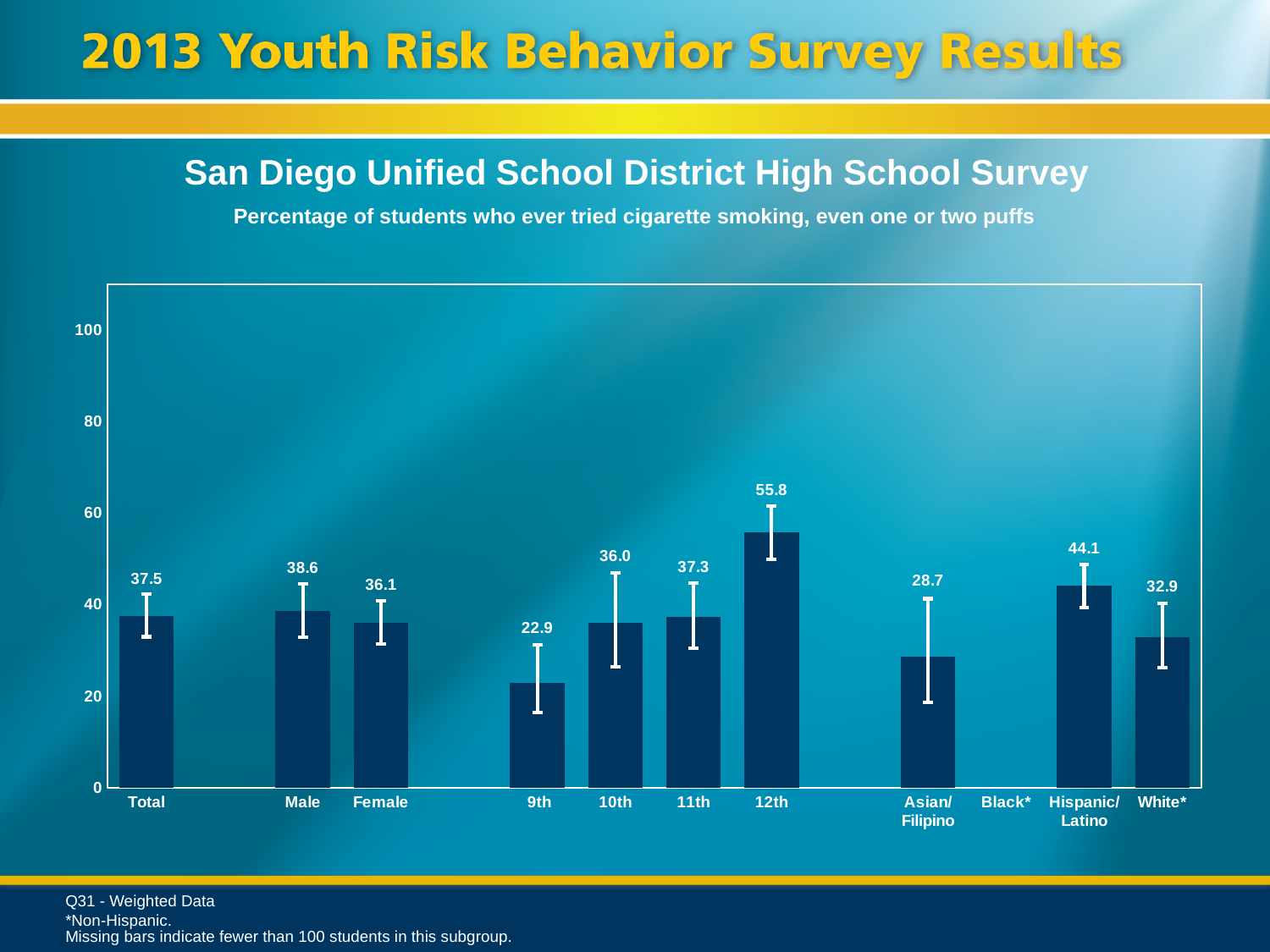
Which is larger, the value for Hispanic/Latino or the value for White*? Hispanic/Latino What is the value for 12th grade? 55.8 Is the value for 9th grade greater or less than 40? less What is the value for Total? 37.5 What is the value for Asian/Filipino? 28.7 What kind of chart is shown? bar chart Which category has no bar shown? Black* What is the difference between the values for Male and Female? 2.5 Which category has the highest value? 12th Which category with a bar has the lowest value? 9th Do the values rise or fall from 9th grade to 12th grade? rise How many categories are labelled on the x axis? 11